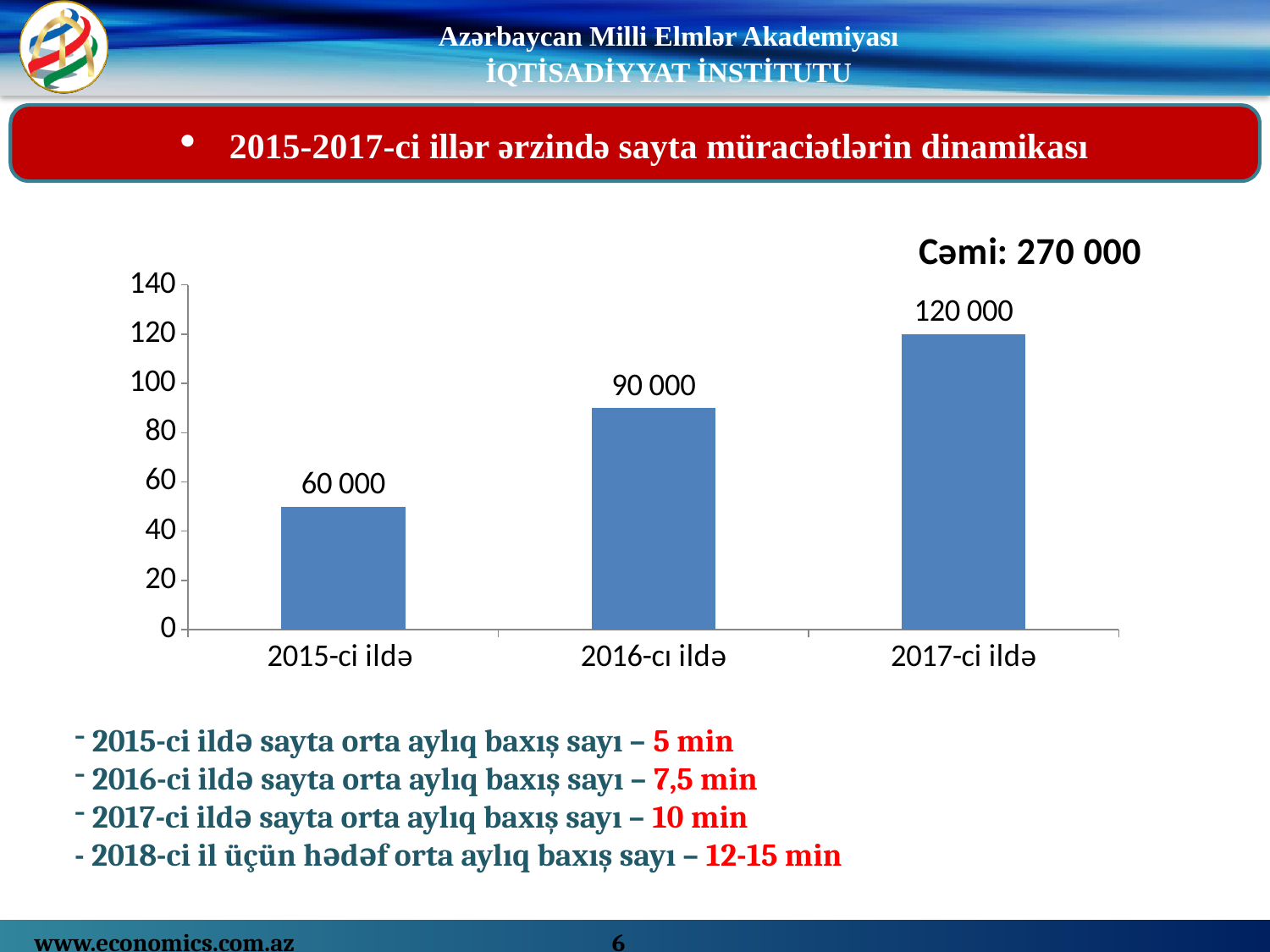
What kind of chart is shown on the slide? bar chart How many bars are shown in the chart? 3 Is the bar for 2017-ci ildə greater or less than 100 on the axis? greater Which year has the lowest value? 2015-ci ildə Which is larger, the value for 2016-cı ildə or the value for 2015-ci ildə? 2016-cı ildə What is the difference between the values for 2017-ci ildə and 2016-cı ildə? 30 000 What is the value shown for 2016-cı ildə? 90 000 What is the difference between the values for 2017-ci ildə and 2015-ci ildə? 60 000 What is the value shown for 2017-ci ildə? 120 000 Do the values rise or fall from 2015-ci ildə to 2017-ci ildə? rise What is the value shown for 2015-ci ildə? 60 000 Which year has the highest value? 2017-ci ildə